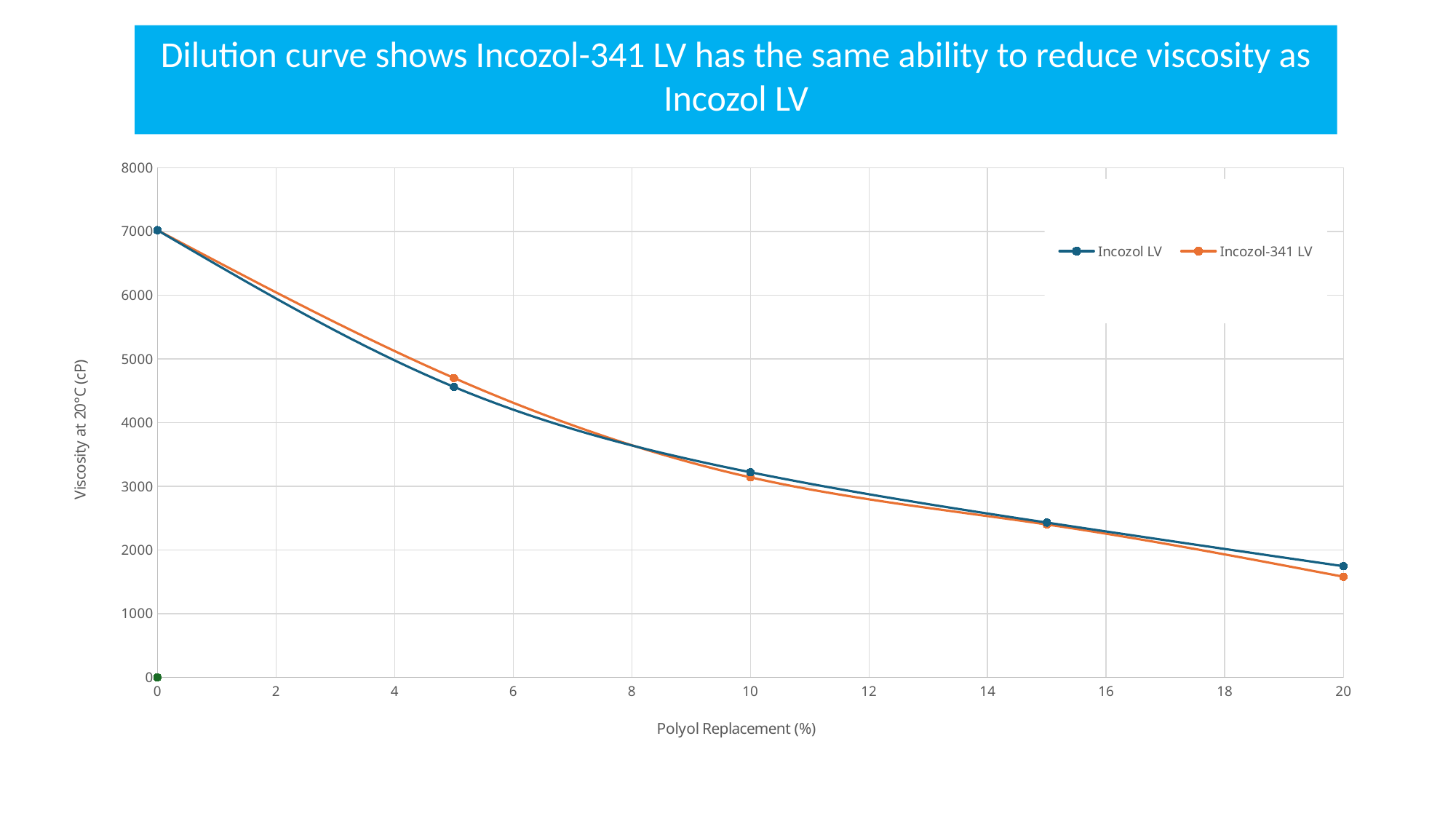
Is the viscosity of Incozol-341 LV at 20% polyol replacement greater or less than 2000? less Do the viscosity values rise or fall as Polyol Replacement (%) increases? Fall Is the viscosity of Incozol-341 LV at 10% polyol replacement greater or less than 3000? greater At 20% polyol replacement, which series has the higher viscosity, Incozol LV or Incozol-341 LV? Incozol LV What is the label of the y axis? Viscosity at 20°C (cP) At 5% polyol replacement, which series has the higher viscosity, Incozol LV or Incozol-341 LV? Incozol-341 LV What kind of chart is shown on the slide? Line chart How many data points are plotted for the Incozol LV series? 5 What is the label of the x axis? Polyol Replacement (%) How many series does the legend list? 2 Is the viscosity of Incozol LV at 5% polyol replacement greater or less than 5000? less